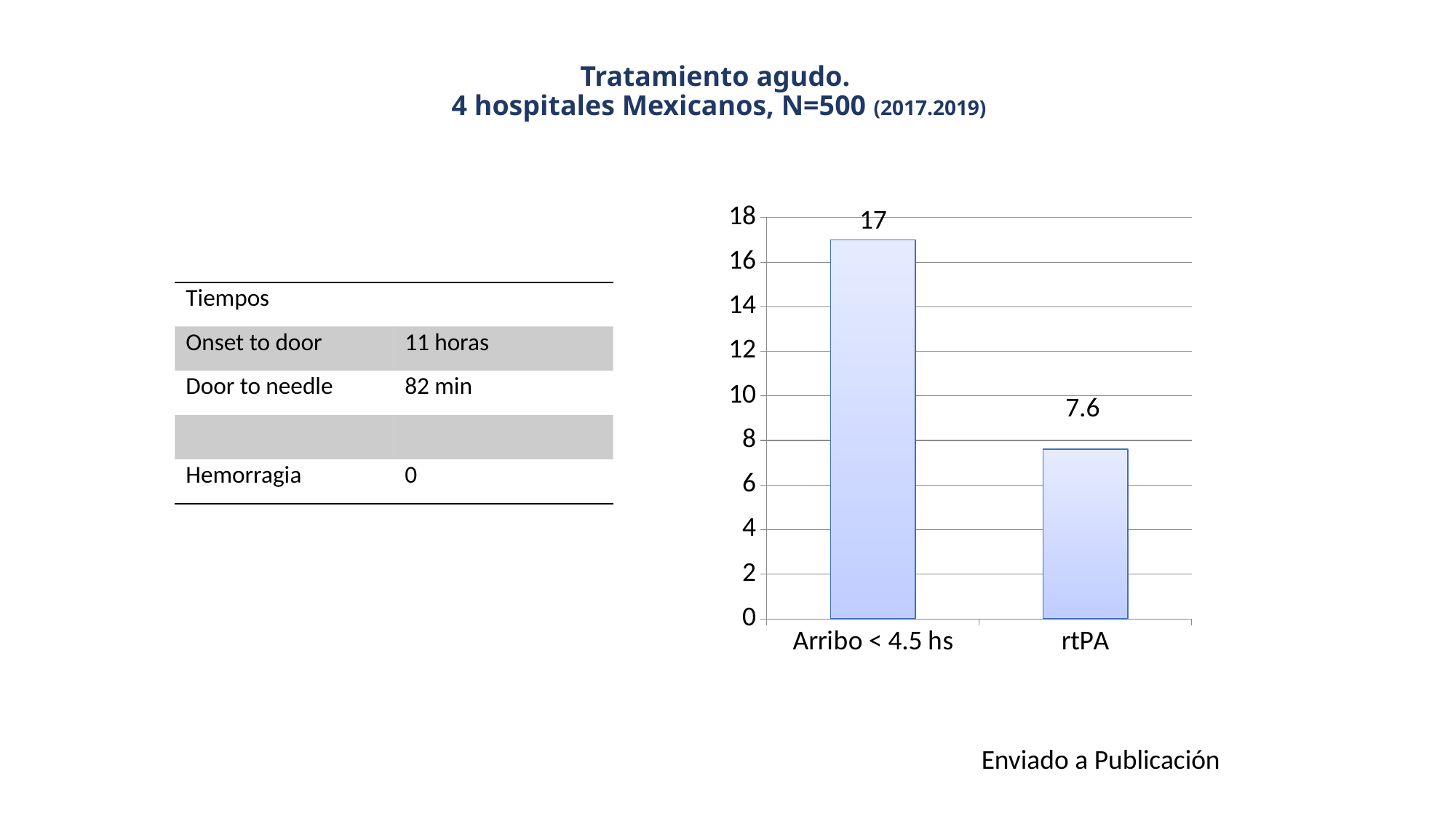
Which is larger, the value for Arribo < 4.5 hs or the value for rtPA? Arribo < 4.5 hs What is the difference between the values for Arribo < 4.5 hs and rtPA? 9.4 Is the value for Arribo < 4.5 hs greater or less than 16? greater Which category has the lowest value? rtPA Is the value for rtPA greater or less than 10? less What is the value for rtPA? 7.6 Which category has the highest value? Arribo < 4.5 hs What is the title of the slide containing the chart? Tratamiento agudo. 4 hospitales Mexicanos, N=500 (2017.2019) What is the value for Arribo < 4.5 hs? 17 What kind of chart is shown on the slide? bar chart How many categories are shown in the chart? 2 What is the maximum value shown on the vertical axis of the chart? 18